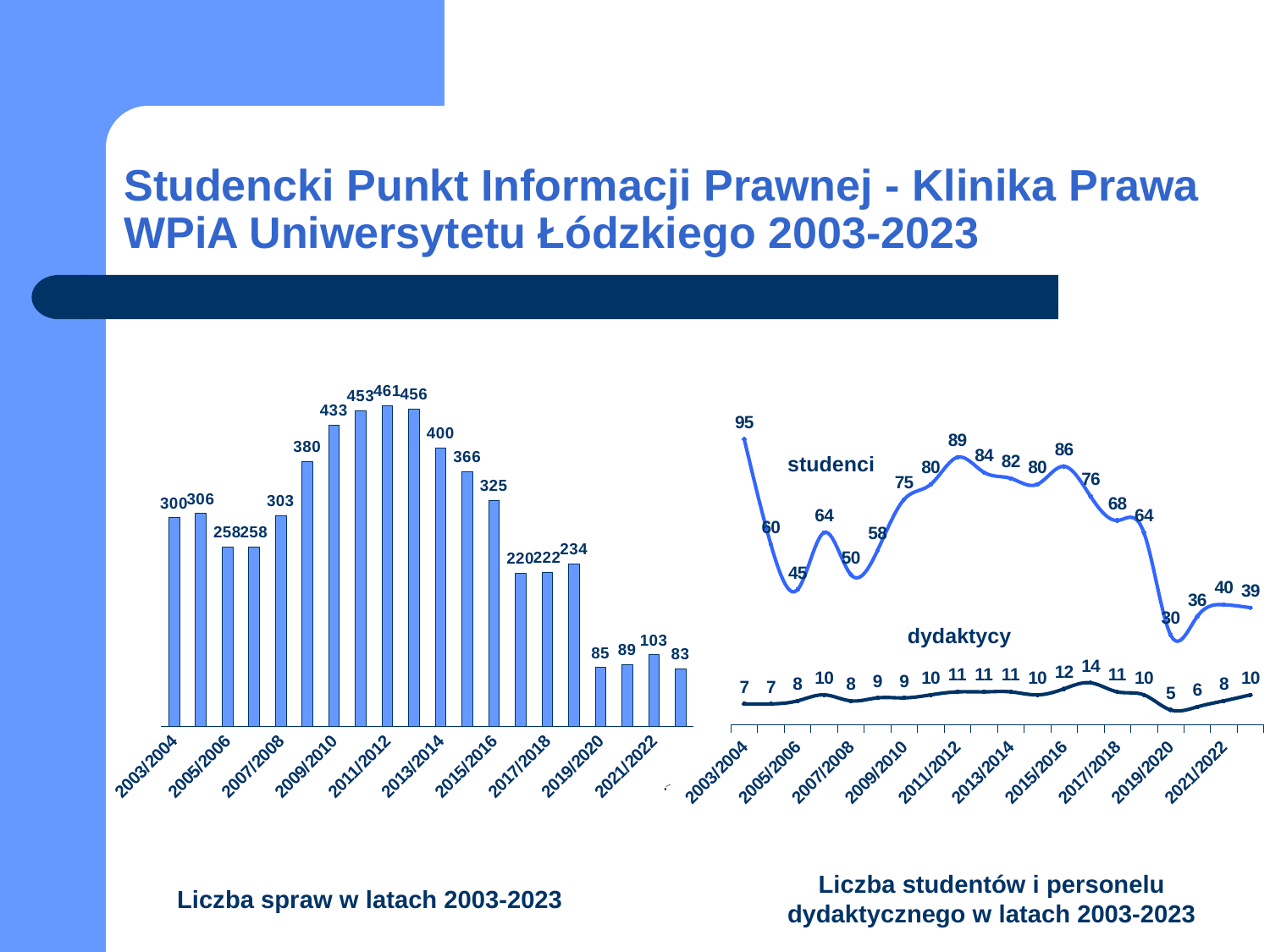
In the left chart 'Liczba spraw w latach 2003-2023', which is larger: the value for 2013/2014 or the value for 2015/2016? 2013/2014 In the left chart 'Liczba spraw w latach 2003-2023', what is the difference between the values for 2009/2010 and 2003/2004? 133 In the right chart 'Liczba studentów i personelu dydaktycznego w latach 2003-2023', what is the value of the 'dydaktycy' series for 2019/2020? 5 How many bars are plotted in the left chart 'Liczba spraw w latach 2003-2023'? 20 In the right chart 'Liczba studentów i personelu dydaktycznego w latach 2003-2023', what is the difference between the 'studenci' and 'dydaktycy' values for 2003/2004? 88 In the left chart 'Liczba spraw w latach 2003-2023', what is the value for 2011/2012? 461 What type of chart is the left chart, 'Liczba spraw w latach 2003-2023'? bar chart In the left chart 'Liczba spraw w latach 2003-2023', which year has the highest value? 2011/2012 In the right chart 'Liczba studentów i personelu dydaktycznego w latach 2003-2023', what is the highest value of the 'studenci' series? 95 In the left chart 'Liczba spraw w latach 2003-2023', what is the value for 2019/2020? 85 In the right chart 'Liczba studentów i personelu dydaktycznego w latach 2003-2023', what is the value of the 'studenci' series for 2011/2012? 89 How many series are plotted in the right chart 'Liczba studentów i personelu dydaktycznego w latach 2003-2023'? 2